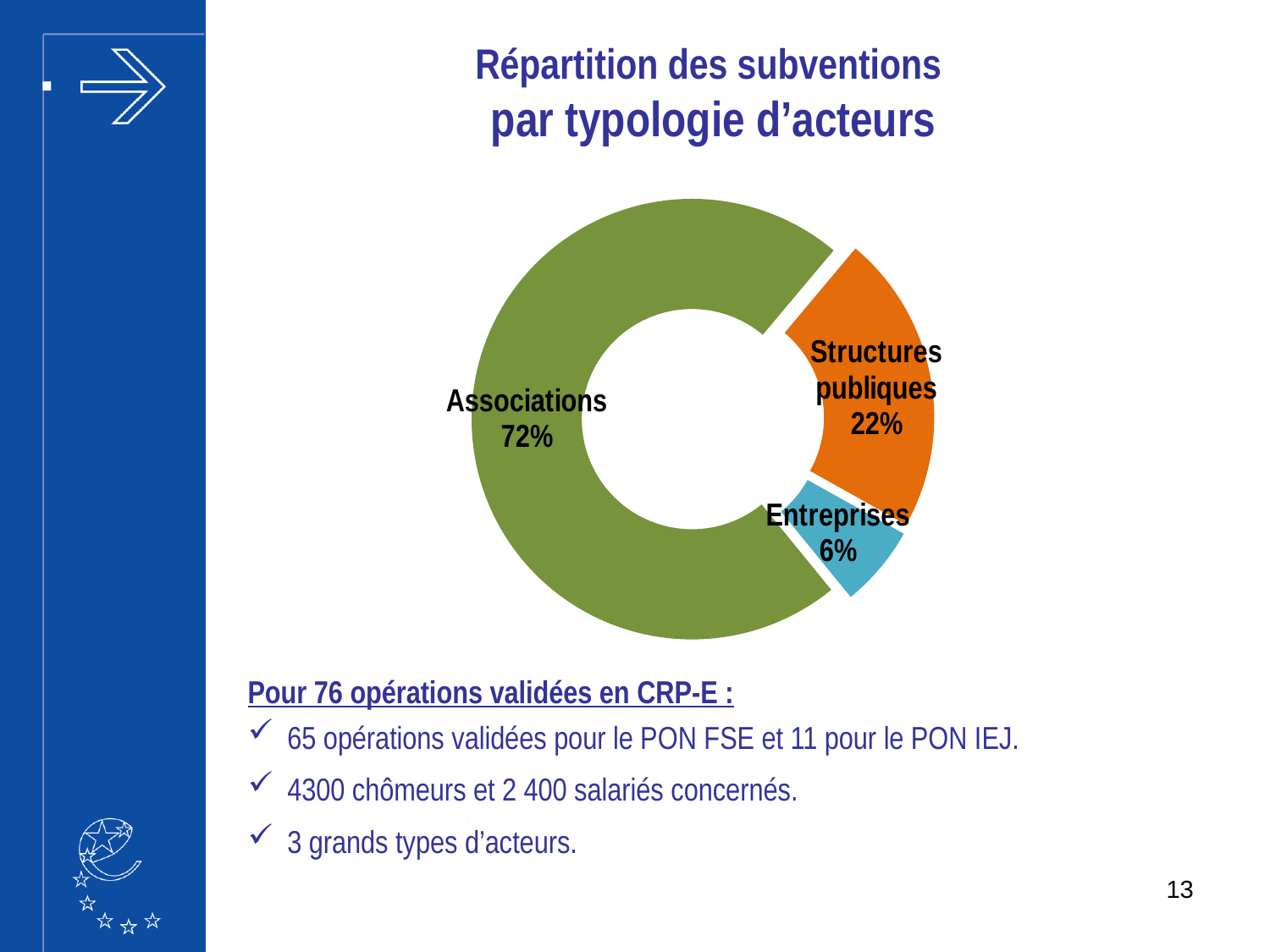
What is the difference in percentage points between the Structures publiques share and the Entreprises share? 16 What is the title of the chart? Répartition des subventions par typologie d'acteurs Which is larger, the share for Structures publiques or the share for Entreprises? Structures publiques Which category receives the smallest share of subsidies? Entreprises What colour is the Entreprises slice? Blue What share of the subsidies goes to Entreprises? 6% How many categories are shown in the chart? 3 What kind of chart is shown on the slide? Doughnut chart What share of the subsidies goes to Structures publiques? 22% What is the difference in percentage points between the Associations share and the Structures publiques share? 50 Which category receives the largest share of subsidies? Associations What share of the subsidies goes to Associations? 72%